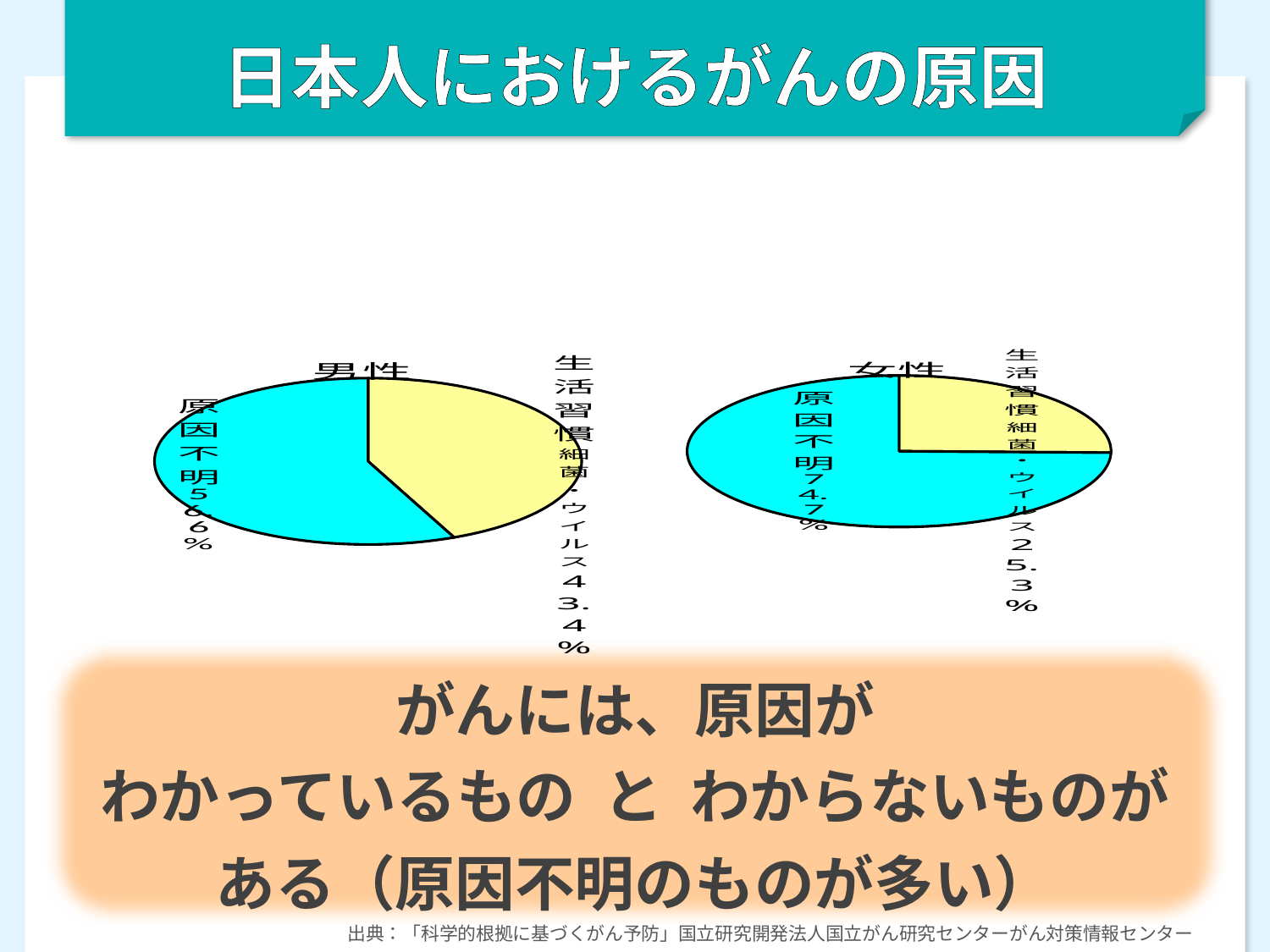
「生活習慣・細菌・ウイルス」の割合は、男性と女性のどちらが大きいですか？ 男性 このスライドのグラフはどの種類のグラフですか？ 円グラフ 「男性」の円グラフには区分がいくつありますか？ 2 このスライドには円グラフがいくつありますか？ 2 「女性」の円グラフで、「原因不明」と「生活習慣・細菌・ウイルス」の割合の差はいくつですか？ 49.4ポイント 「女性」の円グラフで、「原因不明」の割合はいくつですか？ 74.7% 「女性」の円グラフで、最も大きい区分はどれですか？ 原因不明 「男性」の円グラフで、「生活習慣・細菌・ウイルス」の割合はいくつですか？ 43.4% 「生活習慣・細菌・ウイルス」の割合について、男性と女性の差はいくつですか？ 18.1ポイント 「女性」の円グラフで、「生活習慣・細菌・ウイルス」の割合はいくつですか？ 25.3% 「男性」の円グラフで、「原因不明」の区分は何色ですか？ 水色 「男性」の円グラフで、最も大きい区分はどれですか？ 原因不明